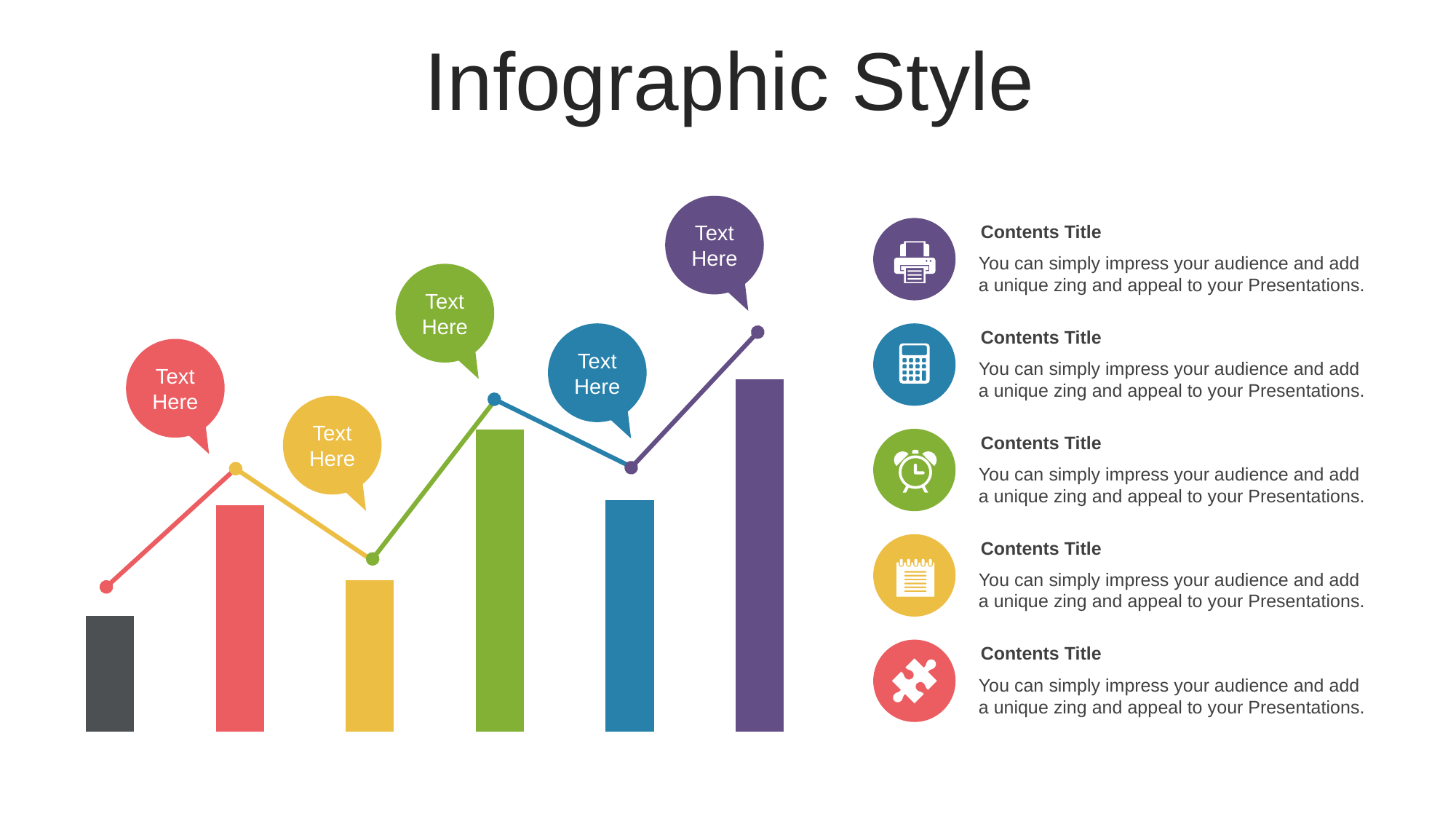
Which bar is taller, the green bar or the yellow bar? the green bar How many 'Text Here' callout bubbles are placed above the chart? 5 How many bars does the chart contain? 6 Which bar is taller, the yellow bar or the red bar? the red bar Which bar is the tallest in the chart? the purple bar (rightmost) What is the title of the slide containing the chart? Infographic Style What kind of chart is shown on the left of the slide? bar chart Is the line overlaid on the bars higher at its right end or its left end? right end Which bar is taller, the blue bar or the red bar? the blue bar Which bar is the shortest in the chart? the dark grey bar (leftmost) Do the bars generally rise or fall from left to right across the chart? rise